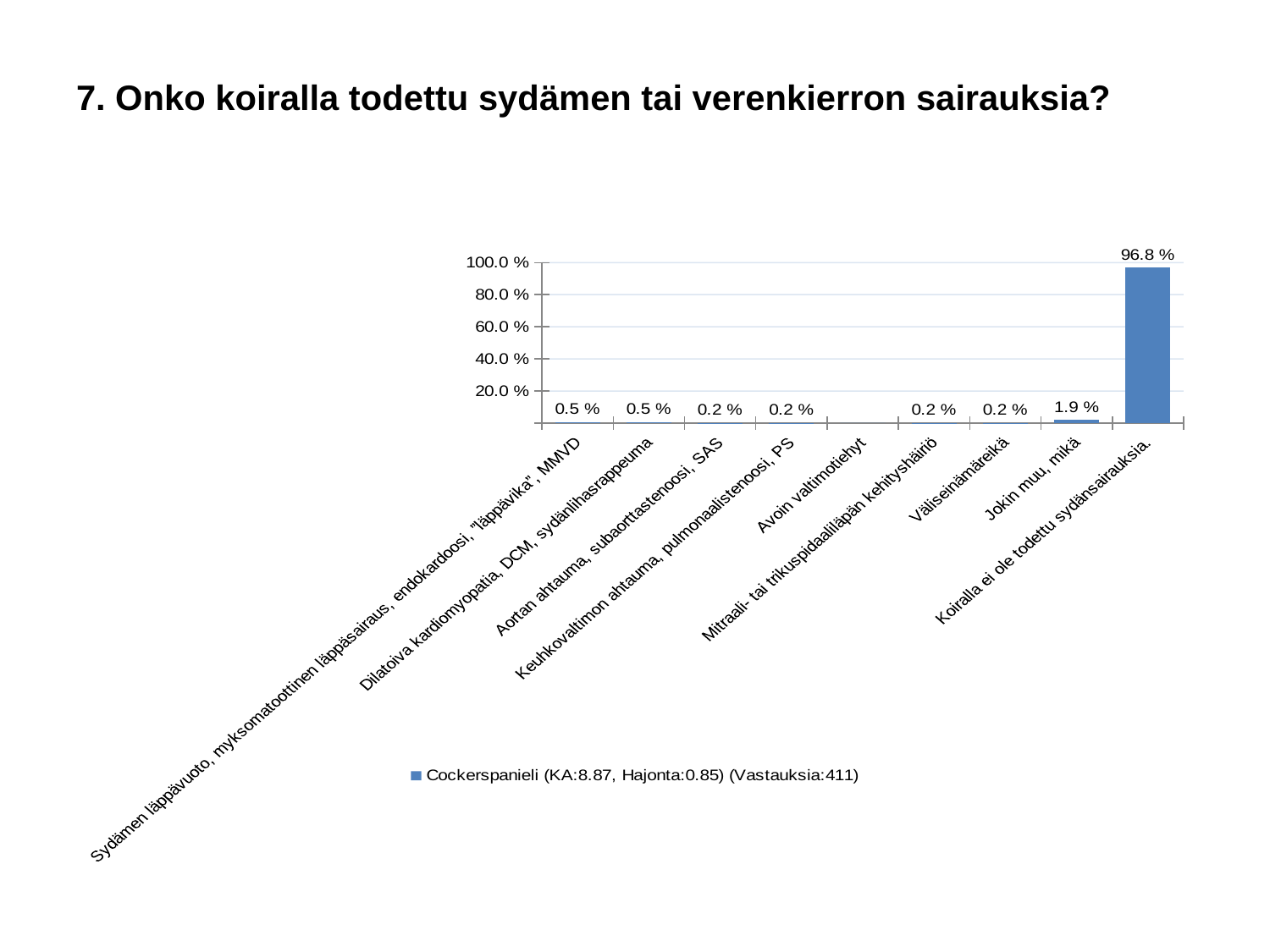
How many categories are shown on the x axis? 9 What kind of chart is shown on the slide? bar chart What is the value for "Dilatoiva kardiomyopatia, DCM, sydänlihasrappeuma"? 0.5 % What is the value for "Jokin muu, mikä"? 1.9 % Is the value for "Koiralla ei ole todettu sydänsairauksia." greater or less than 80.0 %? greater How many series does the legend list? 1 What is the value for "Aortan ahtauma, subaorttastenoosi, SAS"? 0.2 % What is the value for "Väliseinämäreikä"? 0.2 % Which category has the highest value? Koiralla ei ole todettu sydänsairauksia. What is the difference between the values for "Koiralla ei ole todettu sydänsairauksia." and "Jokin muu, mikä"? 94.9 % What is the value for "Koiralla ei ole todettu sydänsairauksia."? 96.8 % Which is larger, the value for "Jokin muu, mikä" or the value for "Keuhkovaltimon ahtauma, pulmonaalistenoosi, PS"? Jokin muu, mikä